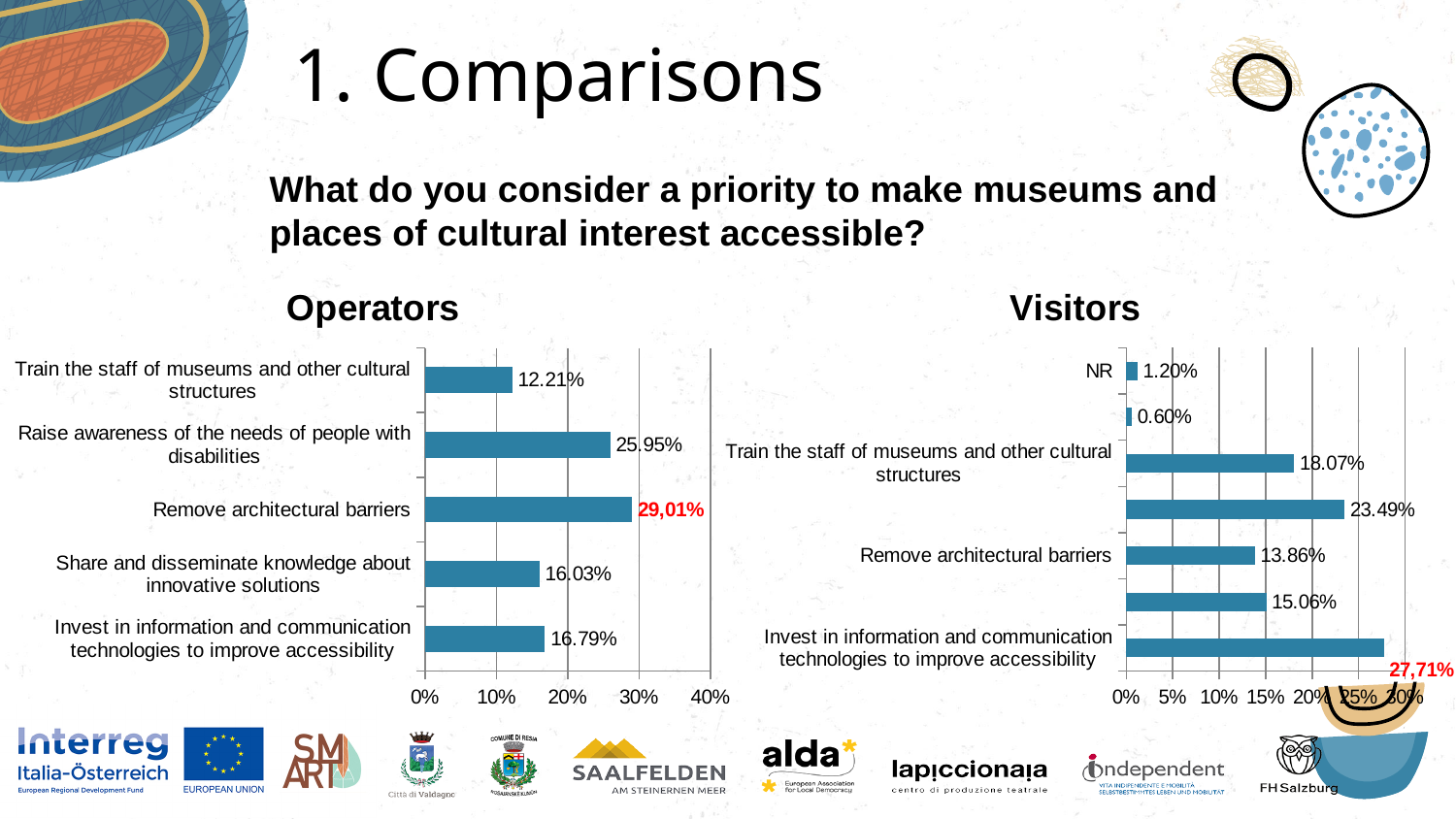
In the Operators chart, what is the value for "Raise awareness of the needs of people with disabilities"? 25.95% In the Operators chart, what is the value for "Remove architectural barriers"? 29,01% How many bars are shown in the Visitors chart? 7 In the Visitors chart, which is larger: "Train the staff of museums and other cultural structures" or "Remove architectural barriers"? Train the staff of museums and other cultural structures In the Visitors chart, what is the value for "NR"? 1.20% In the Operators chart, which category has the lowest value? Train the staff of museums and other cultural structures In the Operators chart, is the value for "Train the staff of museums and other cultural structures" greater or less than 20%? less What type of chart is the Visitors chart? Bar chart In the Operators chart, which category has the highest value? Remove architectural barriers In the Operators chart, what is the difference between "Invest in information and communication technologies to improve accessibility" and "Share and disseminate knowledge about innovative solutions"? 0.76% In the Visitors chart, what is the value for "Invest in information and communication technologies to improve accessibility"? 27,71% How many categories are shown in the Operators chart? 5